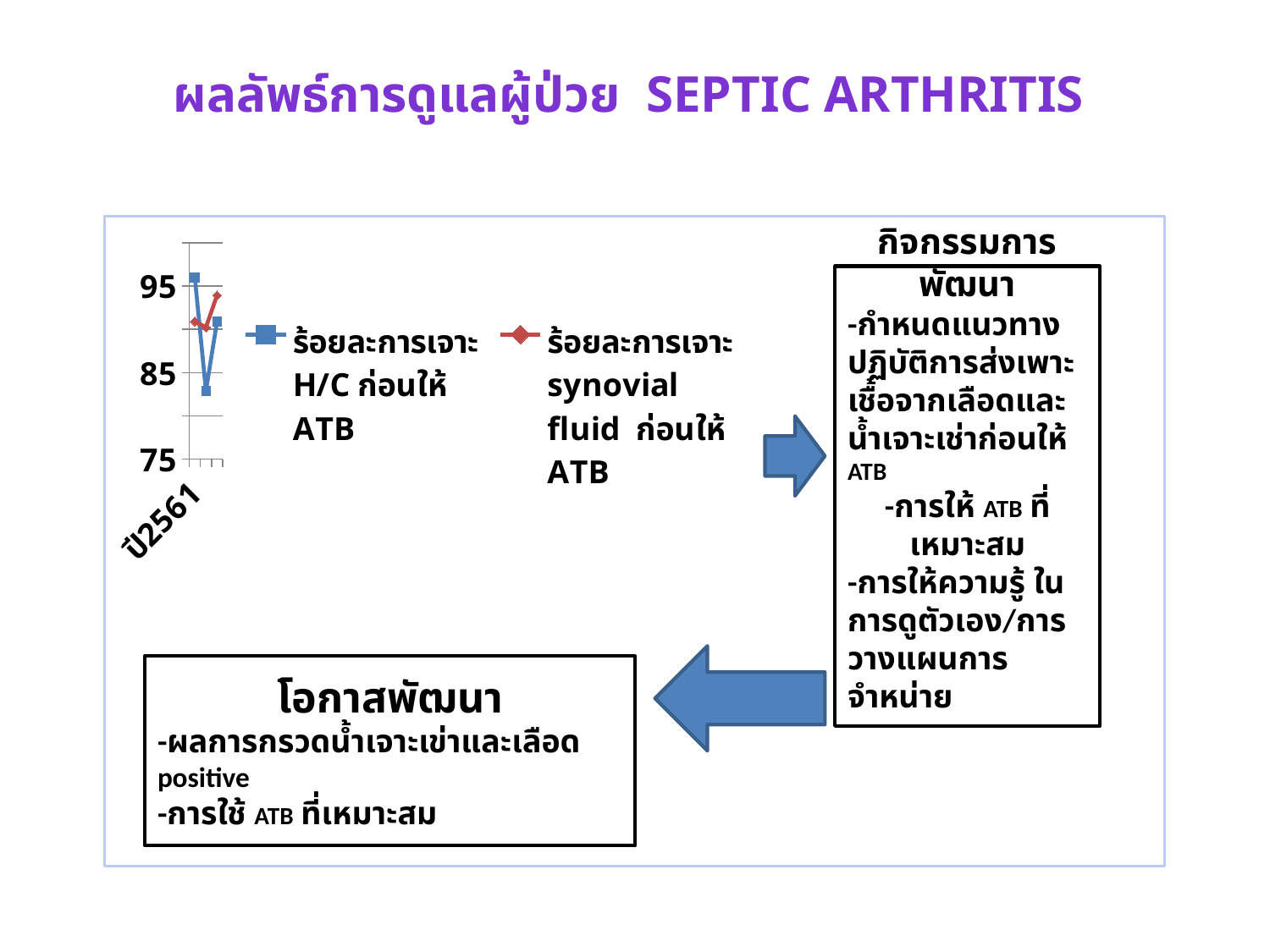
Which series in the chart is drawn in blue? ร้อยละการเจาะ H/C ก่อนให้ ATB Is the value for ปี2561 in the ร้อยละการเจาะ H/C ก่อนให้ ATB series greater or less than 85? greater For ปี2561, which series has the larger value: ร้อยละการเจาะ H/C ก่อนให้ ATB or ร้อยละการเจาะ synovial fluid ก่อนให้ ATB? ร้อยละการเจาะ H/C ก่อนให้ ATB Is the value for ปี2561 in the ร้อยละการเจาะ synovial fluid ก่อนให้ ATB series greater or less than 85? greater How many series does the chart's legend list? 2 Which series in the chart is drawn in red? ร้อยละการเจาะ synovial fluid ก่อนให้ ATB What kind of chart is shown on the slide? line chart Is the value for ปี2561 in the ร้อยละการเจาะ synovial fluid ก่อนให้ ATB series greater or less than 95? less